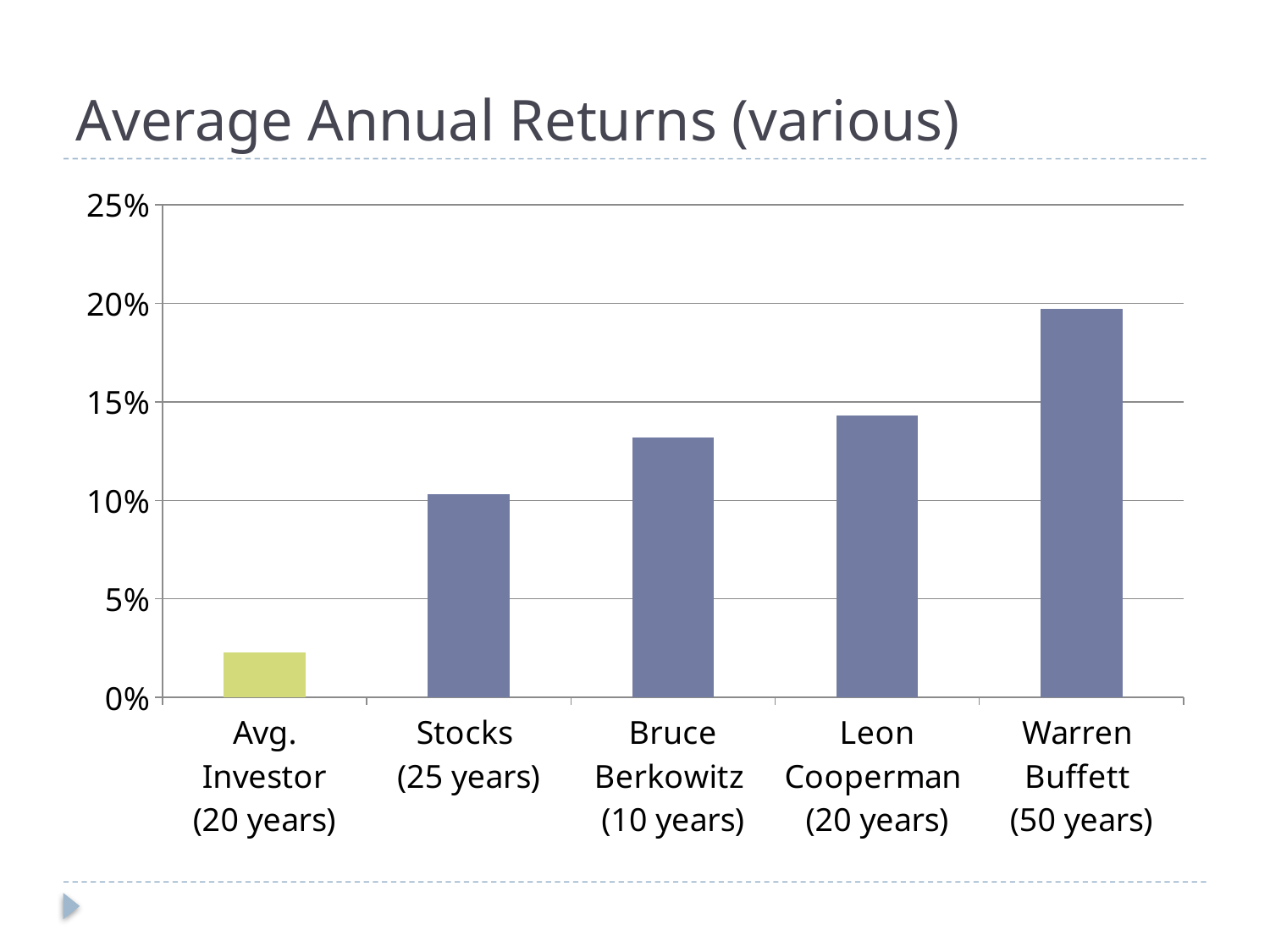
Is the value for Stocks (25 years) greater or less than 15%? less Which bar is shown in a different colour from the others? Avg. Investor (20 years) What type of chart is shown on the slide? bar chart Which is larger, the value for Warren Buffett (50 years) or the value for Stocks (25 years)? Warren Buffett (50 years) What is the title of the chart? Average Annual Returns (various) Is the value for Bruce Berkowitz (10 years) greater or less than 15%? less How many categories are shown on the x axis? 5 Which category has the lowest average annual return? Avg. Investor (20 years) Which category has the highest average annual return? Warren Buffett (50 years) Do the values rise or fall moving from left to right along the x axis? rise Is the value for Warren Buffett (50 years) greater or less than 15%? greater